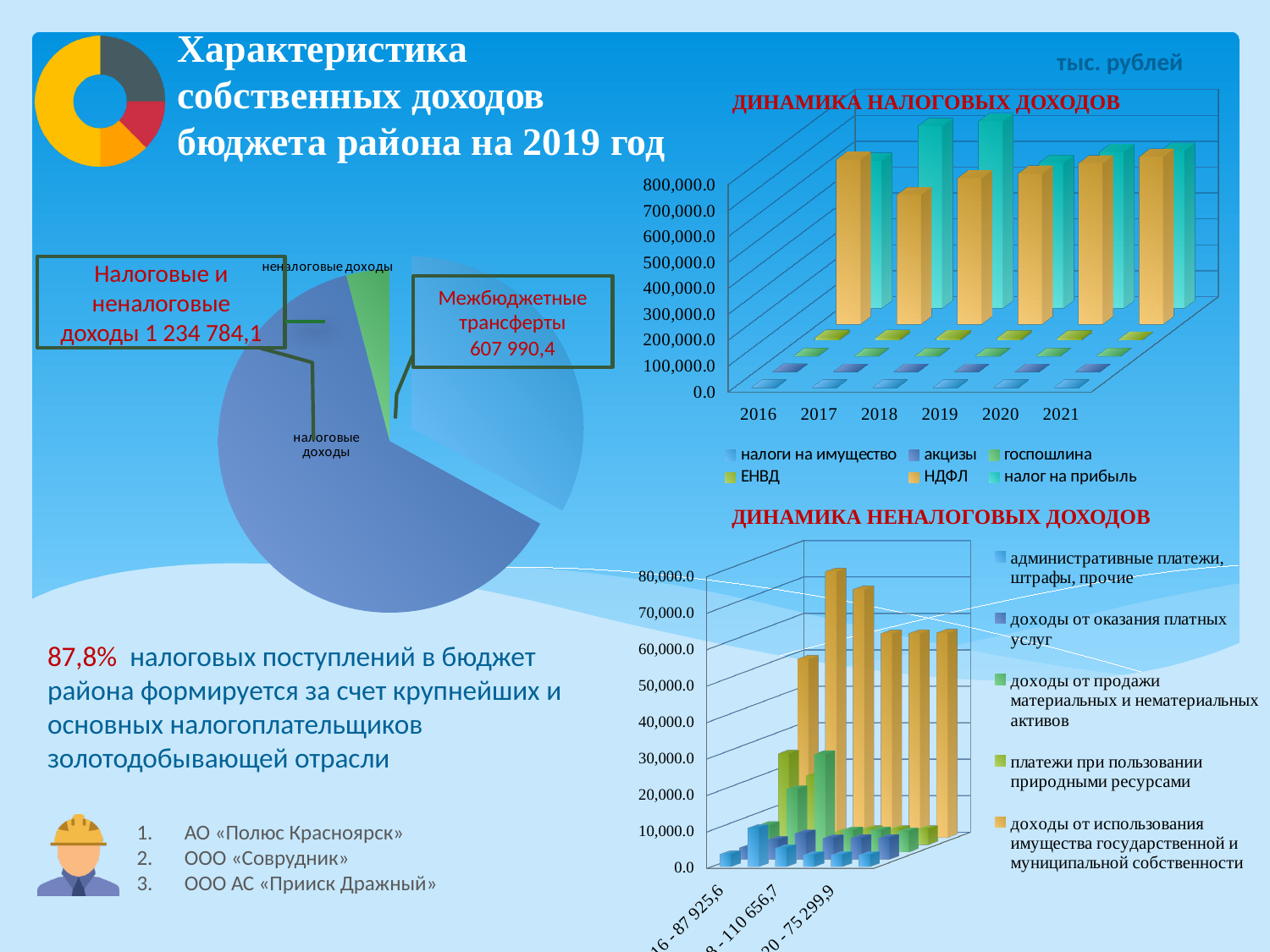
In the 'ДИНАМИКА НАЛОГОВЫХ ДОХОДОВ' chart, what is the first year shown on the x axis? 2016 What kind of chart is the 'ДИНАМИКА НАЛОГОВЫХ ДОХОДОВ' chart? bar chart How many years are shown on the x axis of the 'ДИНАМИКА НАЛОГОВЫХ ДОХОДОВ' chart? 6 In the 'ДИНАМИКА НАЛОГОВЫХ ДОХОДОВ' chart, which year has the larger 'налог на прибыль' value, 2017 or 2018? 2018 How many series does the legend of the 'ДИНАМИКА НЕНАЛОГОВЫХ ДОХОДОВ' chart list? 5 In the 'ДИНАМИКА НАЛОГОВЫХ ДОХОДОВ' chart, which year has the larger НДФЛ value, 2016 or 2017? 2016 How many series does the legend of the 'ДИНАМИКА НАЛОГОВЫХ ДОХОДОВ' chart list? 6 What kind of chart is the chart on the left of the slide with the slices 'налоговые доходы' and 'неналоговые доходы'? pie chart What is the title of the lower chart on the right side of the slide? ДИНАМИКА НЕНАЛОГОВЫХ ДОХОДОВ According to the callout on the pie chart, what is the value of 'Налоговые и неналоговые доходы'? 1 234 784,1 What unit is stated above the 'ДИНАМИКА НАЛОГОВЫХ ДОХОДОВ' chart? тыс. рублей According to the callout on the pie chart, what is the value of 'Межбюджетные трансферты'? 607 990,4